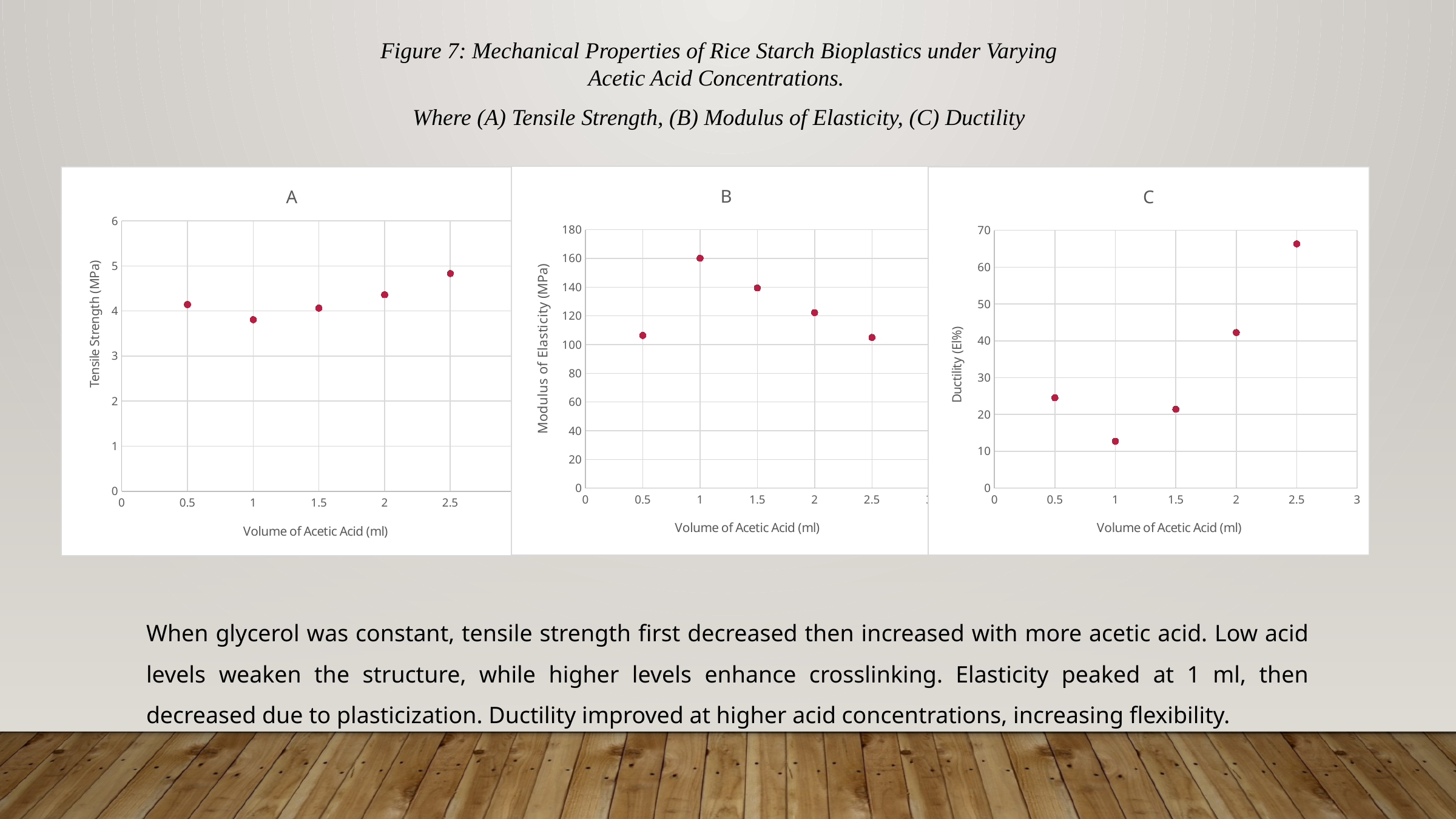
In chart B, is the modulus of elasticity at 2 ml greater or less than 140? less In chart B, is the modulus of elasticity at 1 ml greater or less than 140? greater In chart B, at which volume of acetic acid is the modulus of elasticity highest? 1 In chart A, is the tensile strength at 2.5 ml greater or less than 4? greater In chart C, at which volume of acetic acid is ductility lowest? 1 How many data points are plotted in chart B? 5 In chart A, at which volume of acetic acid is tensile strength highest? 2.5 What is the y-axis title of chart B? Modulus of Elasticity (MPa) What kind of chart is chart A? scatter chart In chart A, at which volume of acetic acid is tensile strength lowest? 1 In chart A, which is larger: the tensile strength at 2 ml or at 1.5 ml? 2 ml